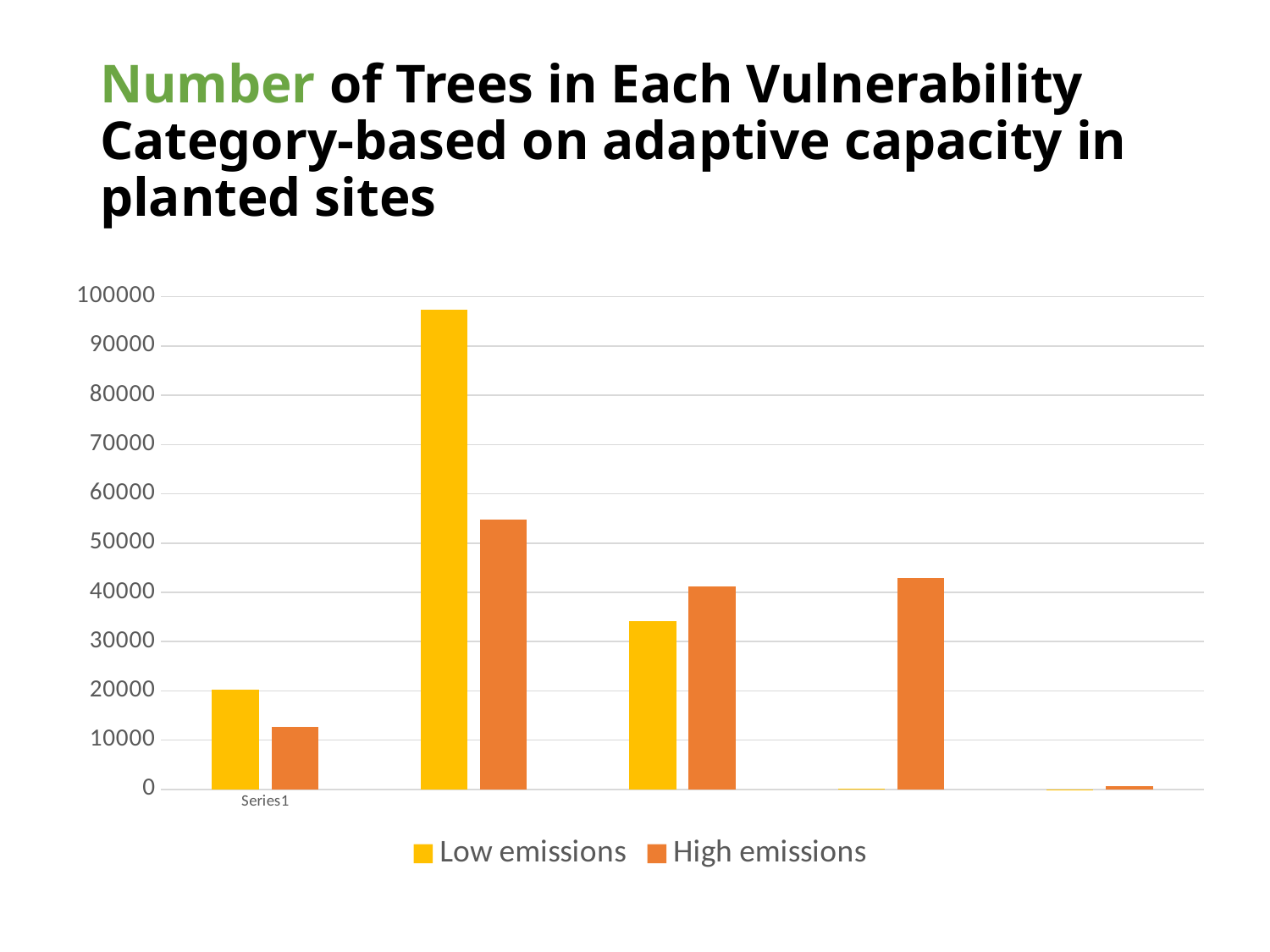
How many series does the legend list? 2 How many groups of bars are plotted along the x axis? 5 What are the two series named in the legend? Low emissions and High emissions What kind of chart is shown on the slide? bar chart What is the highest value shown on the vertical axis? 100000 For Series1, which series has the larger value, Low emissions or High emissions? Low emissions Is the Low emissions value for Series1 greater or less than 30000? less Is the tallest bar on the chart greater or less than 90000? greater Is the Low emissions value for Series1 greater or less than 10000? greater What colour are the Low emissions bars? yellow Which series contains the tallest bar on the chart? Low emissions